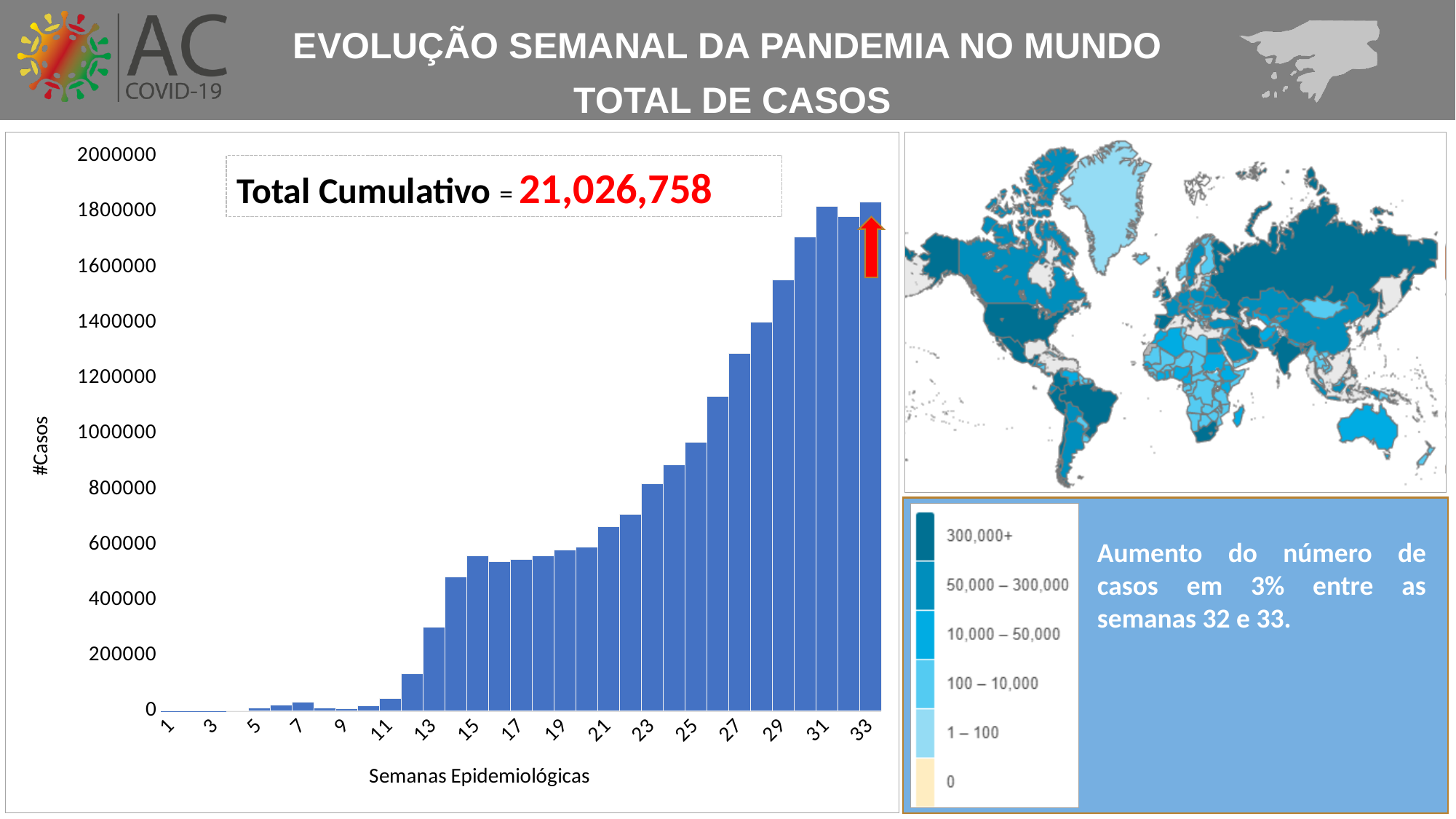
What is the title of the x axis of the bar chart? Semanas Epidemiológicas What kind of chart is used to show the weekly evolution of cases? bar chart Is the value for week 29 greater or less than 1400000? greater What cumulative total is stated in the box on the bar chart? 21,026,758 Is the value for week 15 greater or less than 600000? less Is the value for week 27 greater or less than 1200000? greater Do the weekly case values generally rise or fall from week 1 to week 33? rise Which week has the larger value, week 11 or week 13? week 13 How many epidemiological weeks are plotted in the bar chart? 33 Which week has the larger value, week 27 or week 29? week 29